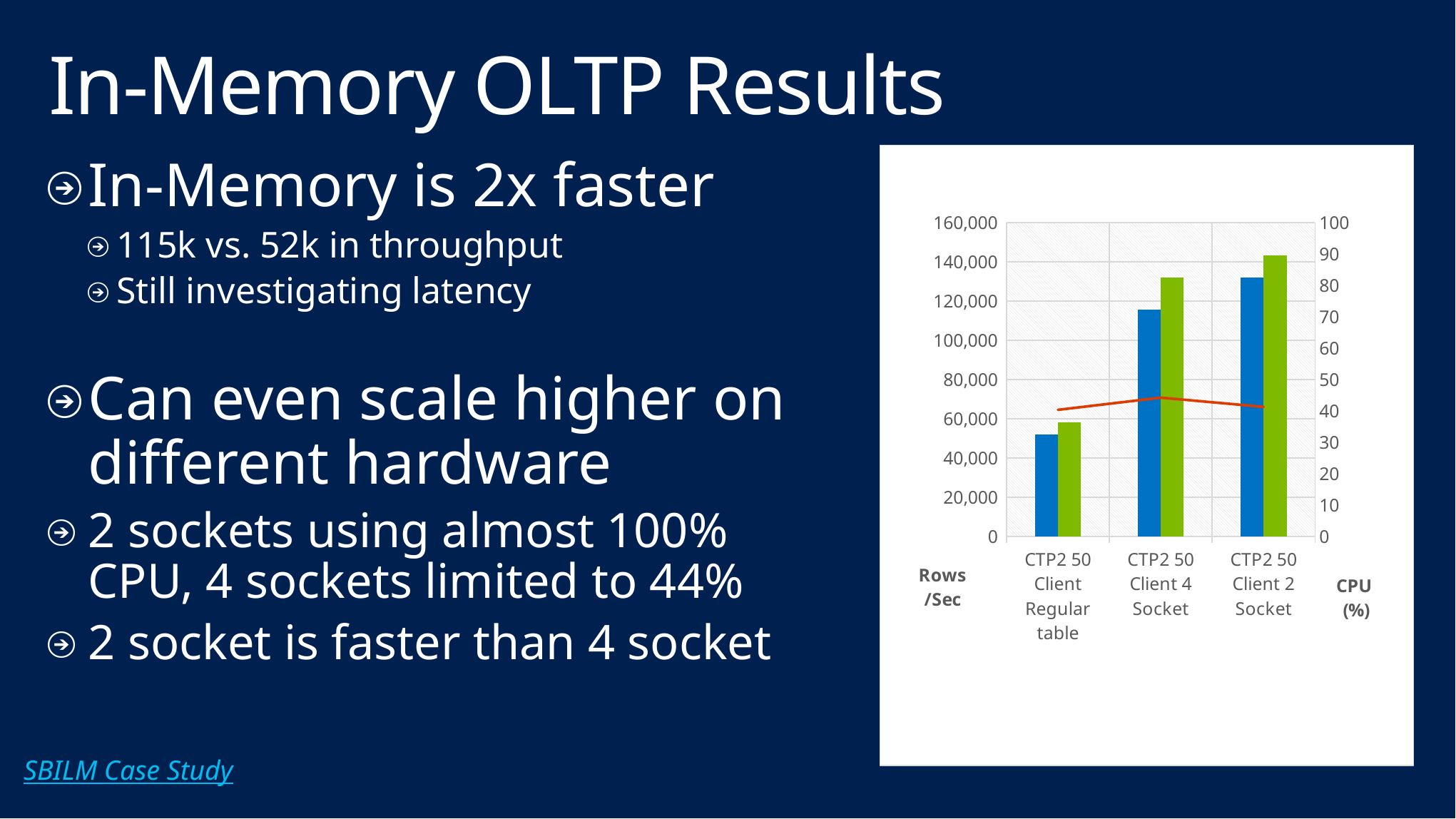
What kind of chart is shown on the slide? combination bar and line chart Do the blue bars rise or fall from left to right across the categories? rise Is the blue bar for CTP2 50 Client 4 Socket greater or less than 100,000? greater Is the orange line value for CTP2 50 Client 4 Socket greater or less than 50 on the right axis? less In the CTP2 50 Client Regular table category, which bar is taller, the blue one or the green one? green How many categories are shown on the x axis of the chart? 3 What is the label of the right-hand vertical axis of the chart? CPU (%) Which has the taller blue bar, CTP2 50 Client 4 Socket or CTP2 50 Client 2 Socket? CTP2 50 Client 2 Socket Is the blue bar for CTP2 50 Client Regular table greater or less than 60,000? less Which category has the tallest blue bar? CTP2 50 Client 2 Socket Which category has the shortest blue bar? CTP2 50 Client Regular table